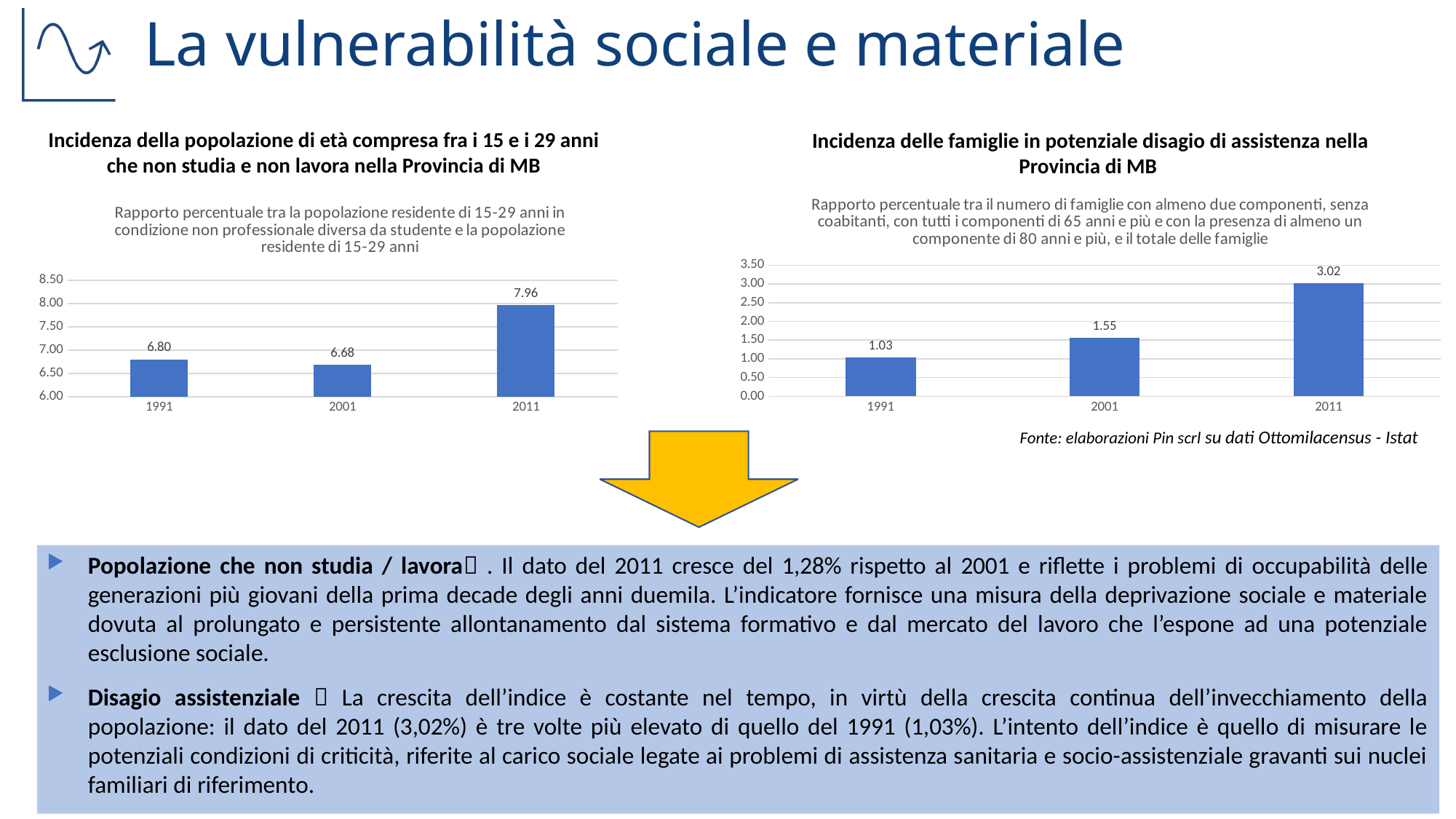
In the left chart (Incidenza della popolazione di età compresa fra i 15 e i 29 anni che non studia e non lavora), what is the difference between the 2011 and 2001 values? 1.28 In the left chart (Incidenza della popolazione di età compresa fra i 15 e i 29 anni che non studia e non lavora), is the value for 1991 larger than the value for 2001? yes In the right chart (Incidenza delle famiglie in potenziale disagio di assistenza), what is the value for 2001? 1.55 In the right chart (Incidenza delle famiglie in potenziale disagio di assistenza), what is the value for 1991? 1.03 What type of chart is the right chart (Incidenza delle famiglie in potenziale disagio di assistenza)? bar chart In the left chart (Incidenza della popolazione di età compresa fra i 15 e i 29 anni che non studia e non lavora), what is the value for 1991? 6.80 In the left chart (Incidenza della popolazione di età compresa fra i 15 e i 29 anni che non studia e non lavora), what is the value for 2011? 7.96 In the right chart (Incidenza delle famiglie in potenziale disagio di assistenza), do the values rise or fall from 1991 to 2011? rise In the right chart (Incidenza delle famiglie in potenziale disagio di assistenza), what is the difference between the 2011 and 1991 values? 1.99 In the left chart (Incidenza della popolazione di età compresa fra i 15 e i 29 anni che non studia e non lavora), how many years are plotted? 3 In the right chart (Incidenza delle famiglie in potenziale disagio di assistenza), which year has the highest value? 2011 In the left chart (Incidenza della popolazione di età compresa fra i 15 e i 29 anni che non studia e non lavora), which year has the lowest value? 2001